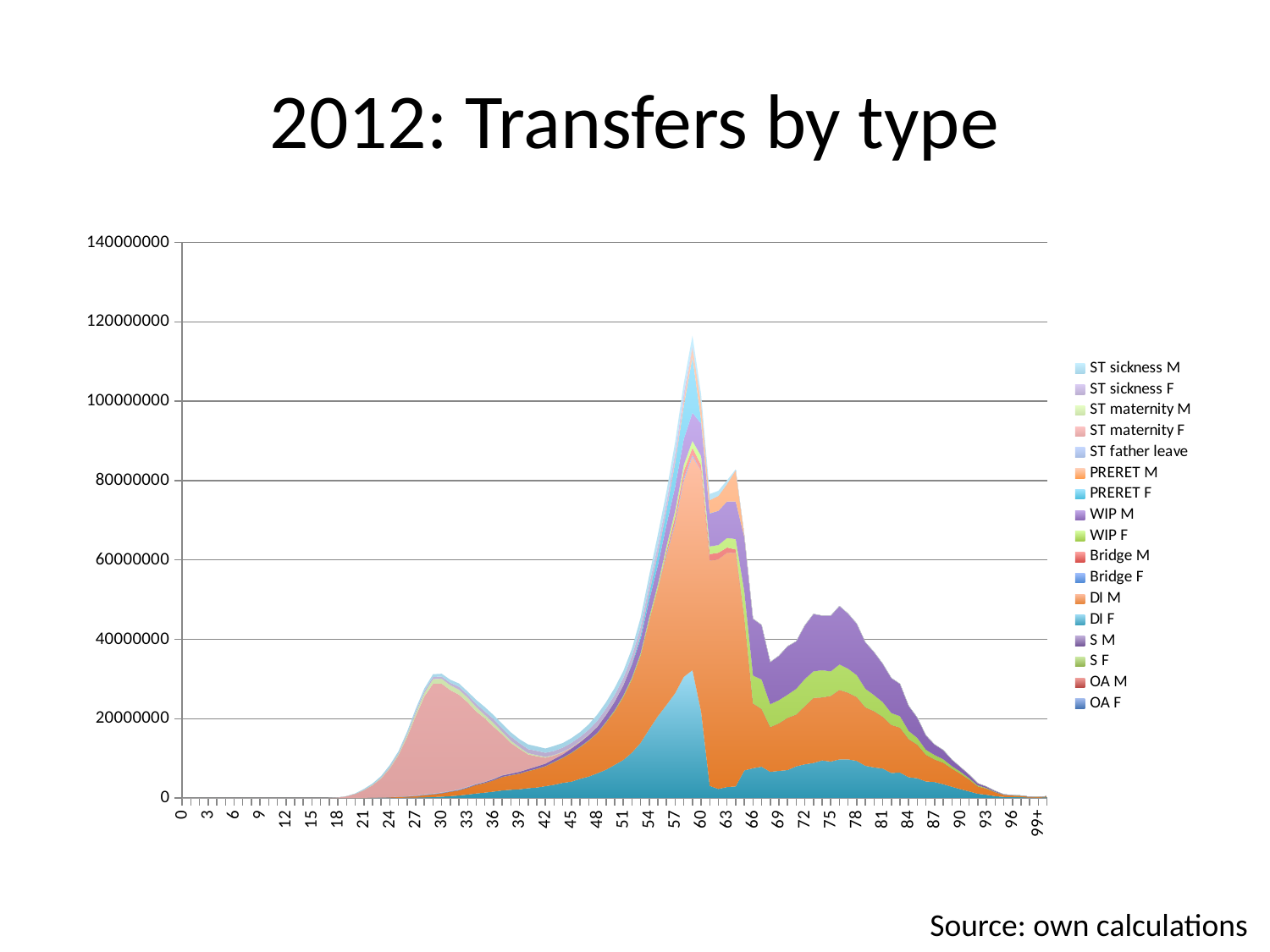
What is the maximum value shown on the vertical axis? 140000000 Do the stacked totals rise or fall along the x axis from age 84 to age 96? Fall Which is larger, the stacked total at age 30 or the stacked total at age 60? Age 60 Is the stacked total at age 75 greater or less than 60000000? less Is the peak of the stacked total (around age 60) greater or less than 100000000? greater Is the stacked total at age 30 greater or less than 40000000? less How many series does the legend list? 17 What kind of chart is shown on the slide? Stacked area chart Which series is listed first (at the top) in the legend? ST sickness M What is the title of the chart? 2012: Transfers by type